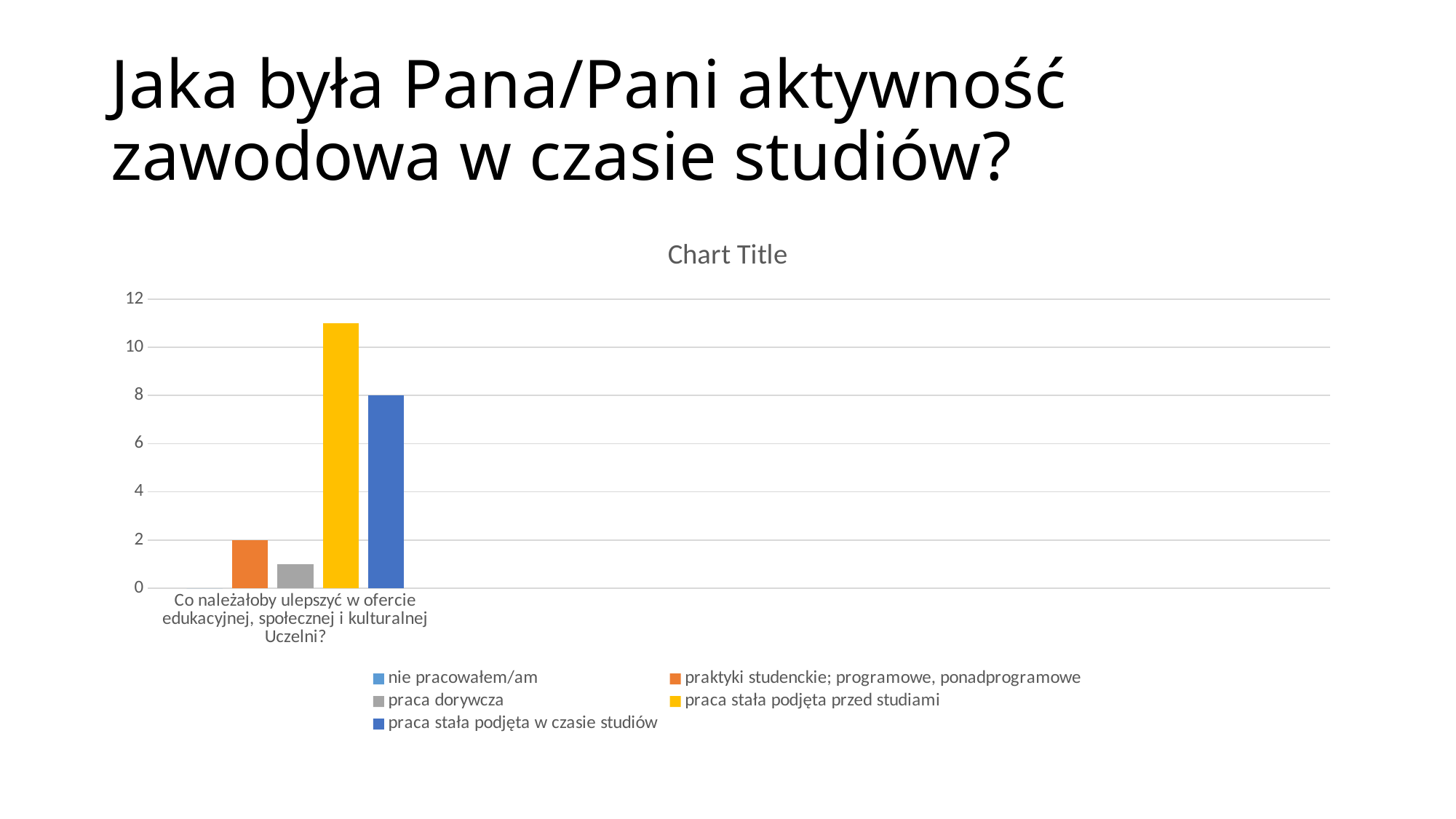
How many series does the legend list? 5 Is the value for 'praca stała podjęta przed studiami' greater or less than 10? greater What is the difference between the values for 'praca stała podjęta w czasie studiów' and 'praktyki studenckie; programowe, ponadprogramowe'? 6 What is the title shown above the chart? Chart Title Which series has the highest value? praca stała podjęta przed studiami What is the value for 'praktyki studenckie; programowe, ponadprogramowe'? 2 Which is larger: 'praca stała podjęta przed studiami' or 'praca stała podjęta w czasie studiów'? praca stała podjęta przed studiami Which series has the lowest value? nie pracowałem/am What kind of chart is shown on the slide? bar chart What is the value for 'praca stała podjęta w czasie studiów'? 8 How many categories are shown on the x axis? 1 Is the value for 'praca dorywcza' greater or less than 2? less